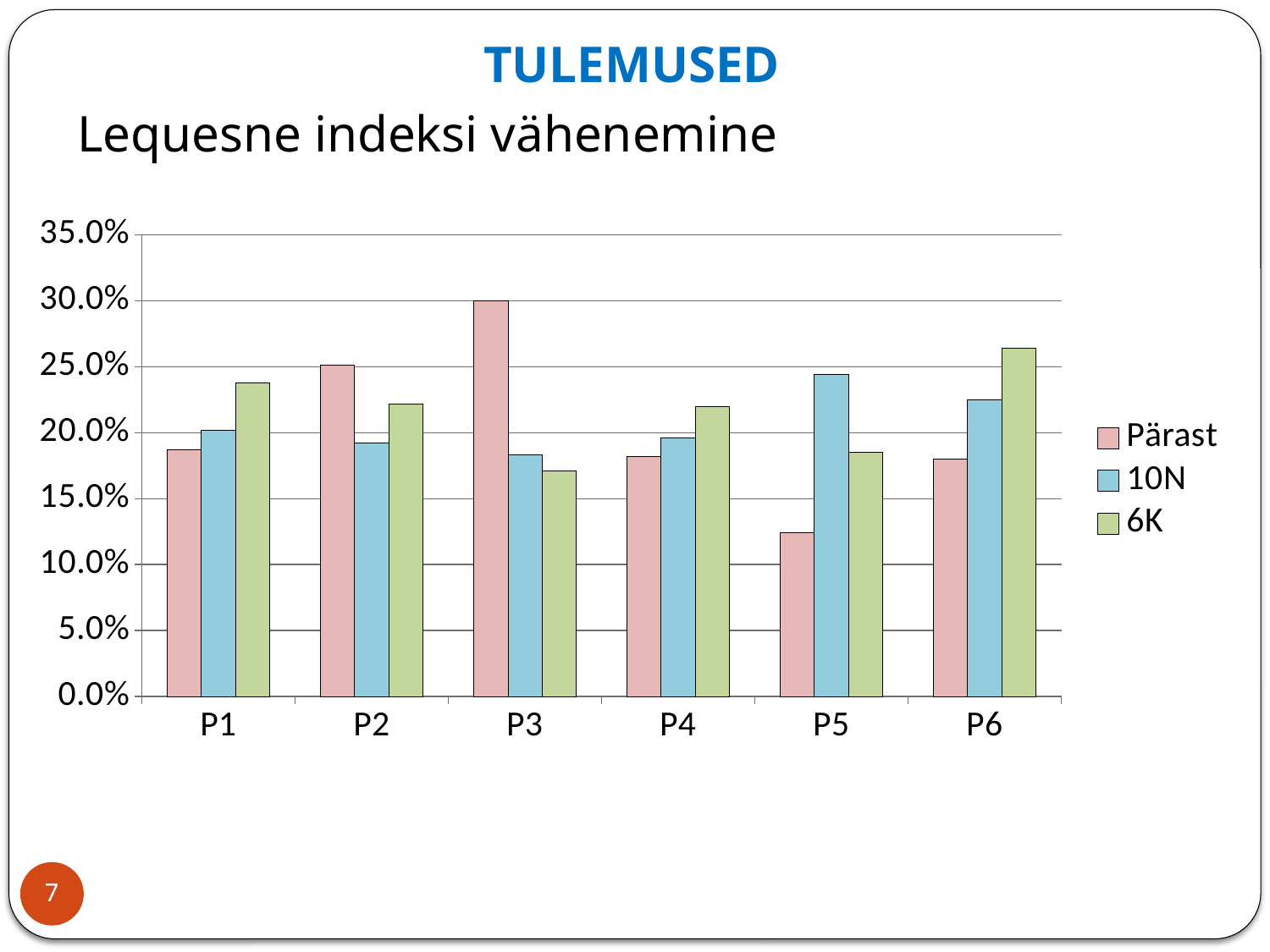
What kind of chart is shown on the slide? bar chart What is the title of the chart? Lequesne indeksi vähenemine Is the 6K value for P6 greater or less than 25.0%? greater For which category is the Pärast value highest? P3 For which category is the 6K value highest? P6 Is the Pärast value for P3 greater or less than 25.0%? greater For which category is the Pärast value lowest? P5 For which category is the 10N value highest? P5 How many categories are shown on the x axis of the chart? 6 For P5, which is larger: the Pärast value or the 10N value? 10N Is the Pärast value for P5 greater or less than 15.0%? less How many series does the chart's legend list? 3